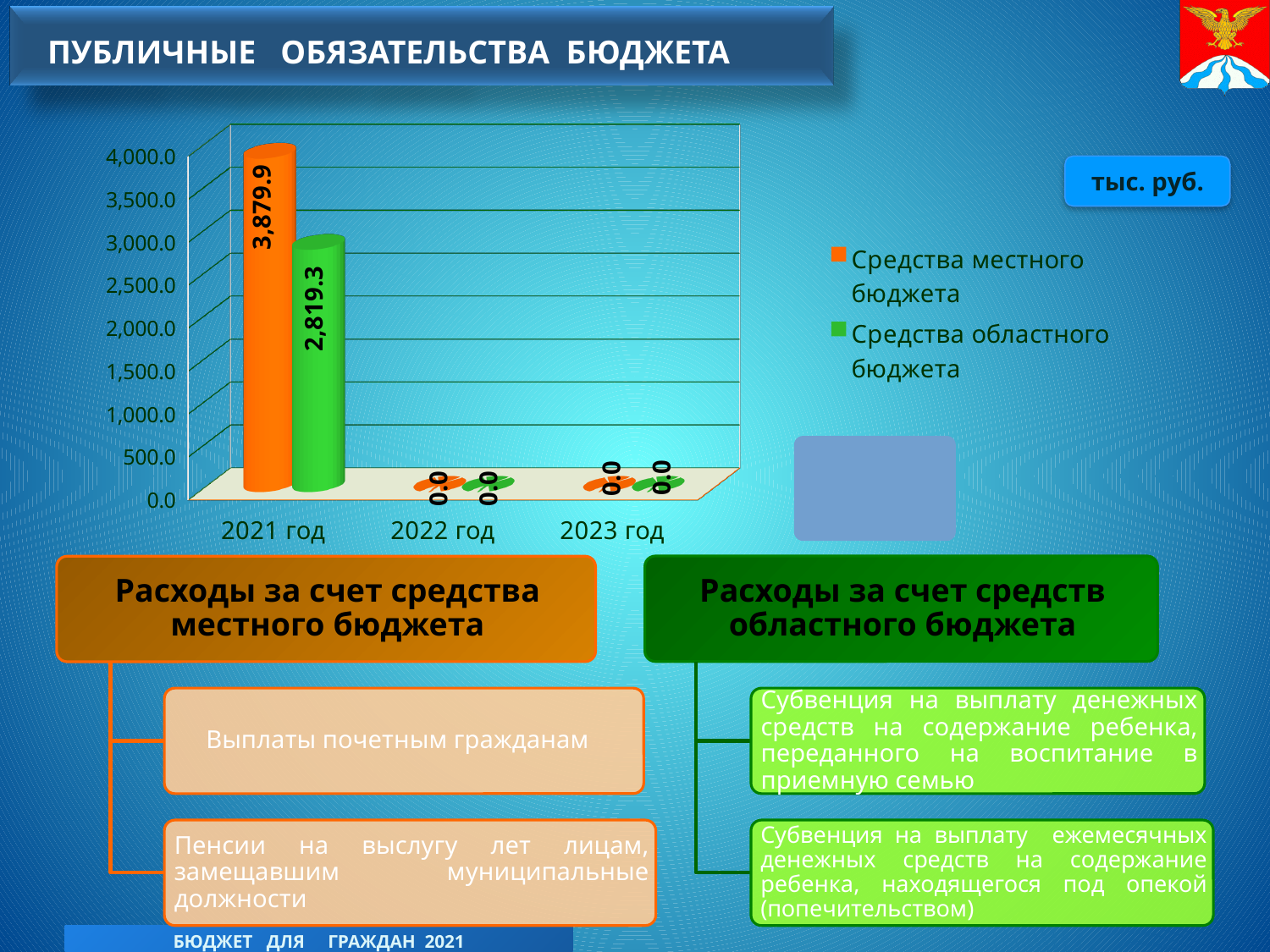
In 2021 год, which is larger: Средства местного бюджета or Средства областного бюджета? Средства местного бюджета What kind of chart is shown on the slide? bar chart What is the value for Средства областного бюджета in 2023 год? 0.0 Is the value for Средства областного бюджета in 2021 год greater or less than 3,000.0? less How many series does the legend list? 2 How many year categories are shown on the x axis? 3 What is the value for Средства местного бюджета in 2022 год? 0.0 Which year has the highest value for Средства местного бюджета? 2021 год What is the value for Средства областного бюджета in 2021 год? 2,819.3 What is the value for Средства местного бюджета in 2021 год? 3,879.9 What is the difference between Средства местного бюджета and Средства областного бюджета in 2021 год? 1,060.6 Which colour represents Средства областного бюджета in the chart? green